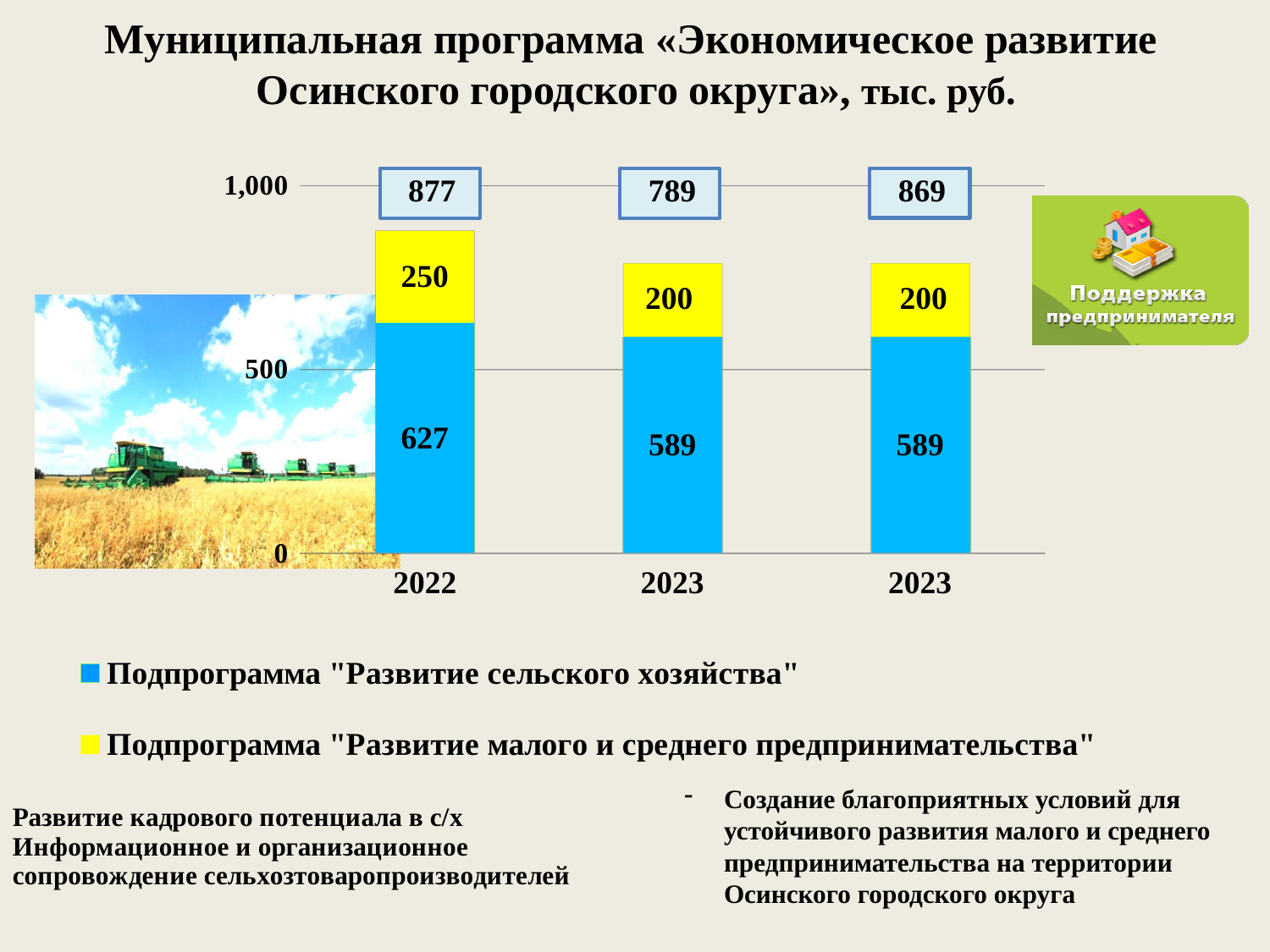
What is the value of the "Развитие сельского хозяйства" subprogram for 2022? 627 What is the value of the "Развитие малого и среднего предпринимательства" subprogram for 2022? 250 How many series does the legend list? 2 Which colour represents the "Развитие малого и среднего предпринимательства" subprogram in the legend? yellow What total is printed above the 2022 bar? 877 What is the value of the "Развитие сельского хозяйства" subprogram in the middle bar (first 2023)? 589 What is the difference between the "Развитие сельского хозяйства" value for 2022 and for the middle bar (627 vs 589)? 38 What kind of chart is shown on the slide? stacked bar chart What total is printed above the rightmost bar? 869 What is the total of the 2022 stacked bar (627 + 250)? 877 How many bars are plotted in the chart? 3 Which bar has the highest total printed above it? 2022